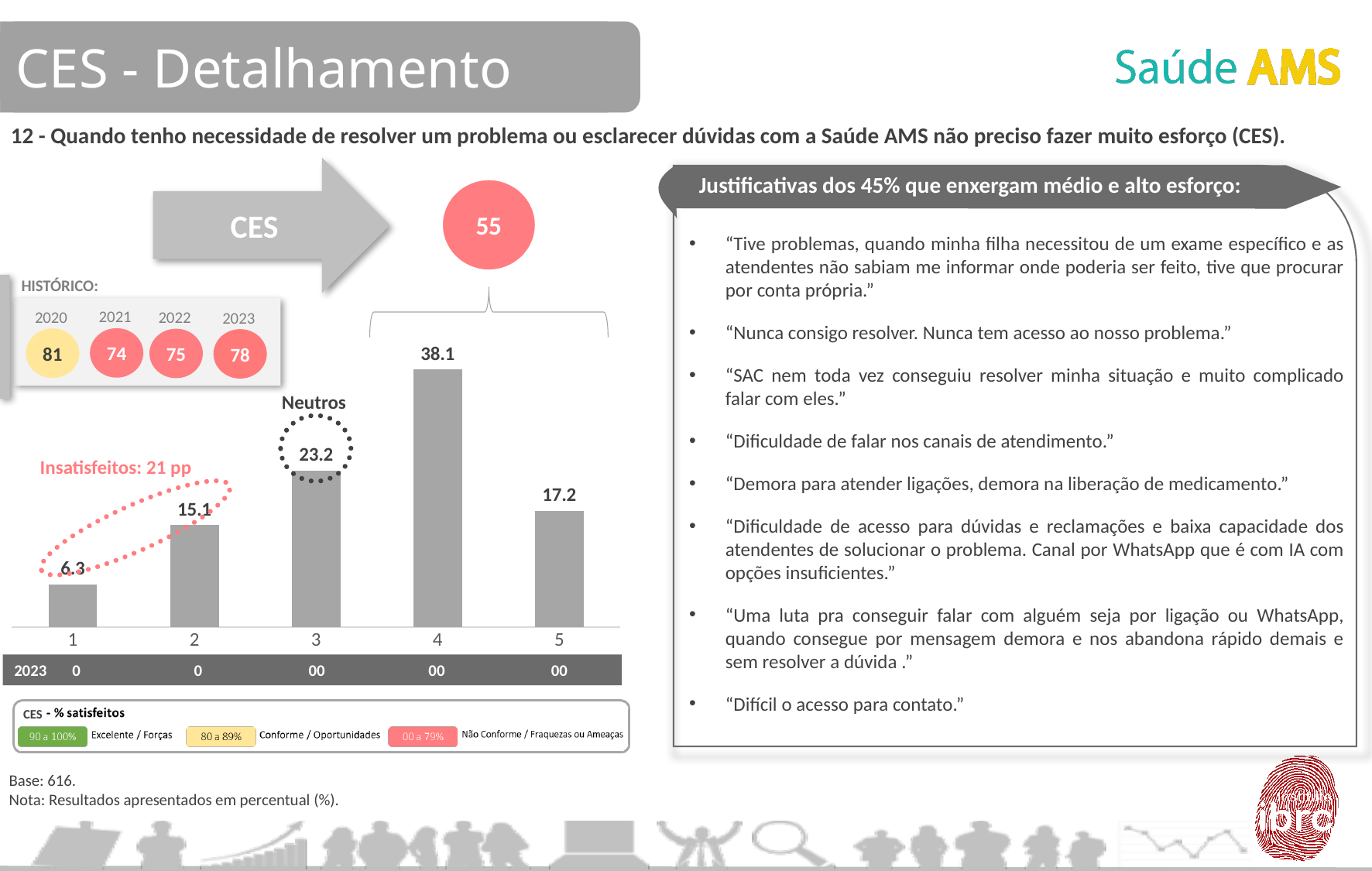
Do the values rise or fall from category 1 to category 4 in the bar chart? rise What is the value for category 4 in the bar chart? 38.1 Which category has the highest value in the bar chart? 4 Which is larger, the value for category 3 or the value for category 5? category 3 What kind of chart is used to show the distribution across categories 1 to 5? bar chart What is the difference between the values for category 4 and category 5? 20.9 What is the difference between the values for category 2 and category 1? 8.8 What is the value for category 3, labelled Neutros, in the bar chart? 23.2 What is the value for category 5 in the bar chart? 17.2 What is the value for category 1 in the bar chart? 6.3 How many categories are shown on the x axis of the bar chart? 5 Which category has the lowest value in the bar chart? 1